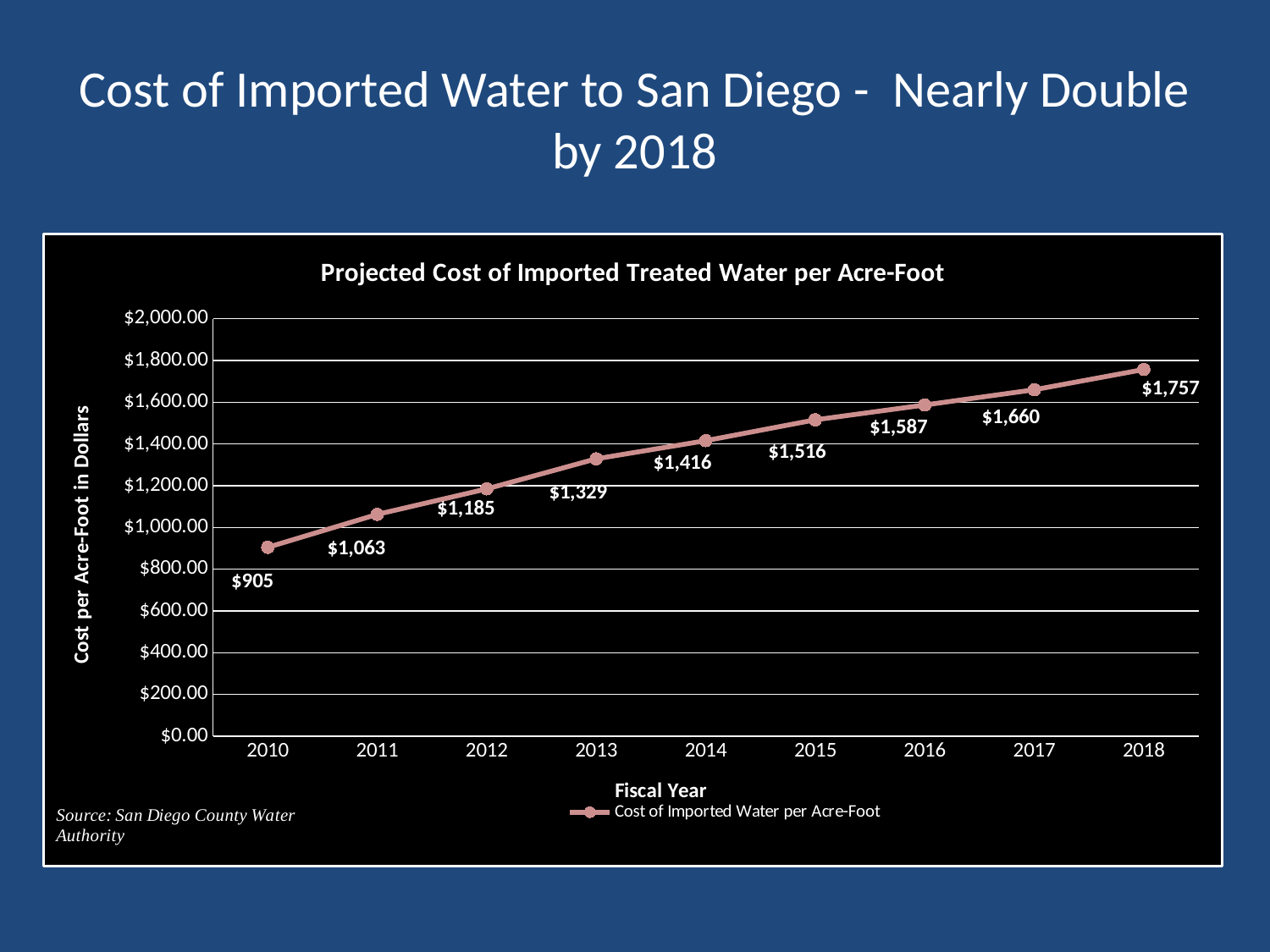
Which year has a higher projected cost, 2015 or 2016? 2016 Does the projected cost rise or fall from 2010 to 2018? Rise What is the difference between the projected cost in 2013 and in 2012? $144 Which fiscal year has the highest projected cost per acre-foot? 2018 How many fiscal years are plotted on the chart? 9 What is the difference between the projected cost in 2018 and the cost in 2010? $852 What is the projected cost of imported water per acre-foot in 2018? $1,757 What is the projected cost of imported water per acre-foot in 2014? $1,416 Is the projected cost for 2017 greater or less than $1,600.00? greater What is the projected cost of imported water per acre-foot in 2010? $905 What kind of chart is shown on the slide? Line chart Which fiscal year has the lowest projected cost per acre-foot? 2010